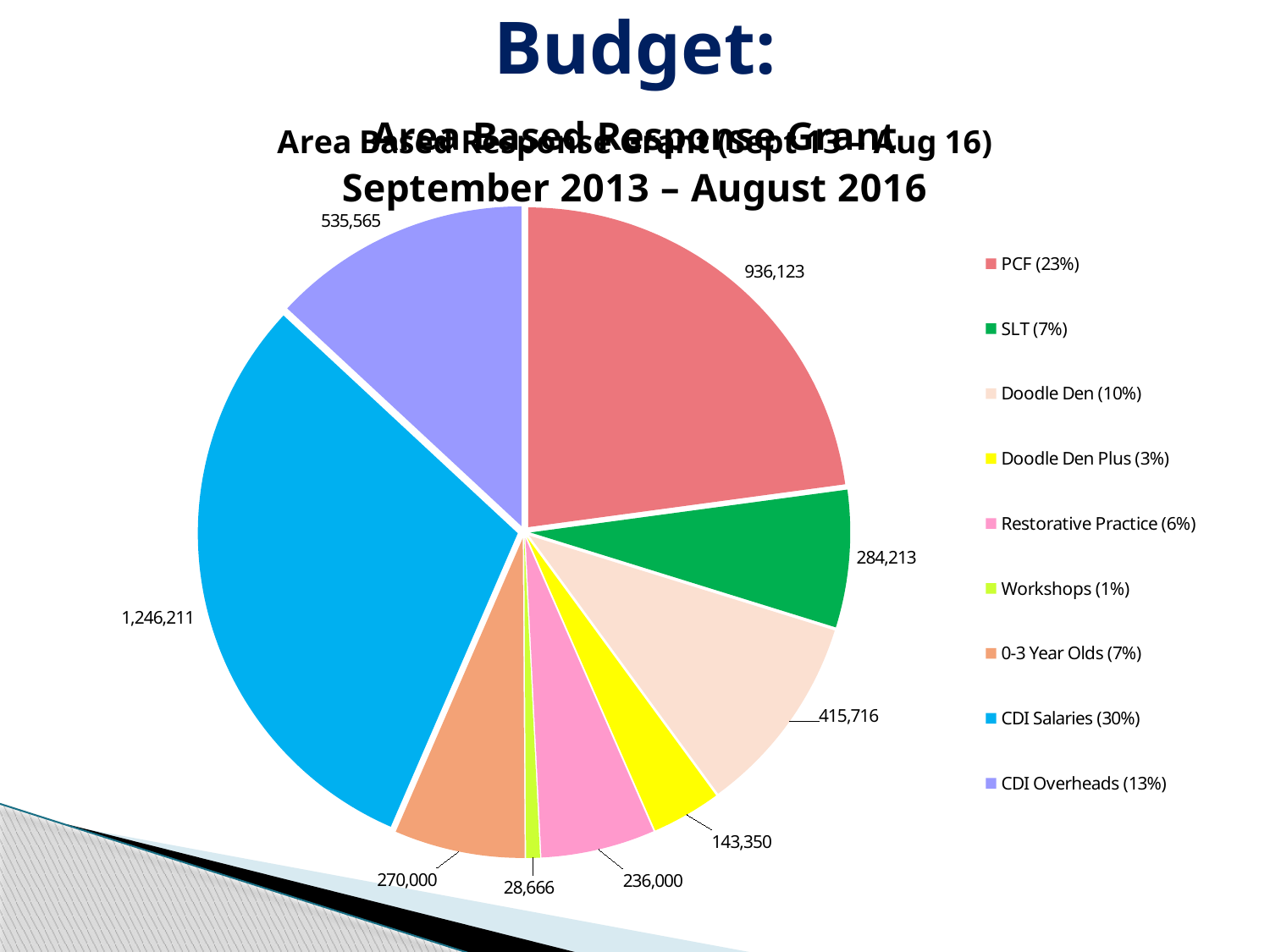
What share of the pie does CDI Overheads represent, according to the legend? 13% What is the value for CDI Salaries? 1,246,211 Which category has the largest slice of the pie? CDI Salaries How many categories does the pie chart have? 9 What is the difference between the values for CDI Salaries and PCF? 310,088 Which is larger, the value for 0-3 Year Olds or the value for Restorative Practice? 0-3 Year Olds What is the value for PCF? 936,123 Which category has the smallest slice of the pie? Workshops What is the value for Doodle Den? 415,716 What share of the pie does Doodle Den Plus represent, according to the legend? 3% What type of chart is shown on the slide? pie chart What is the value for Workshops? 28,666